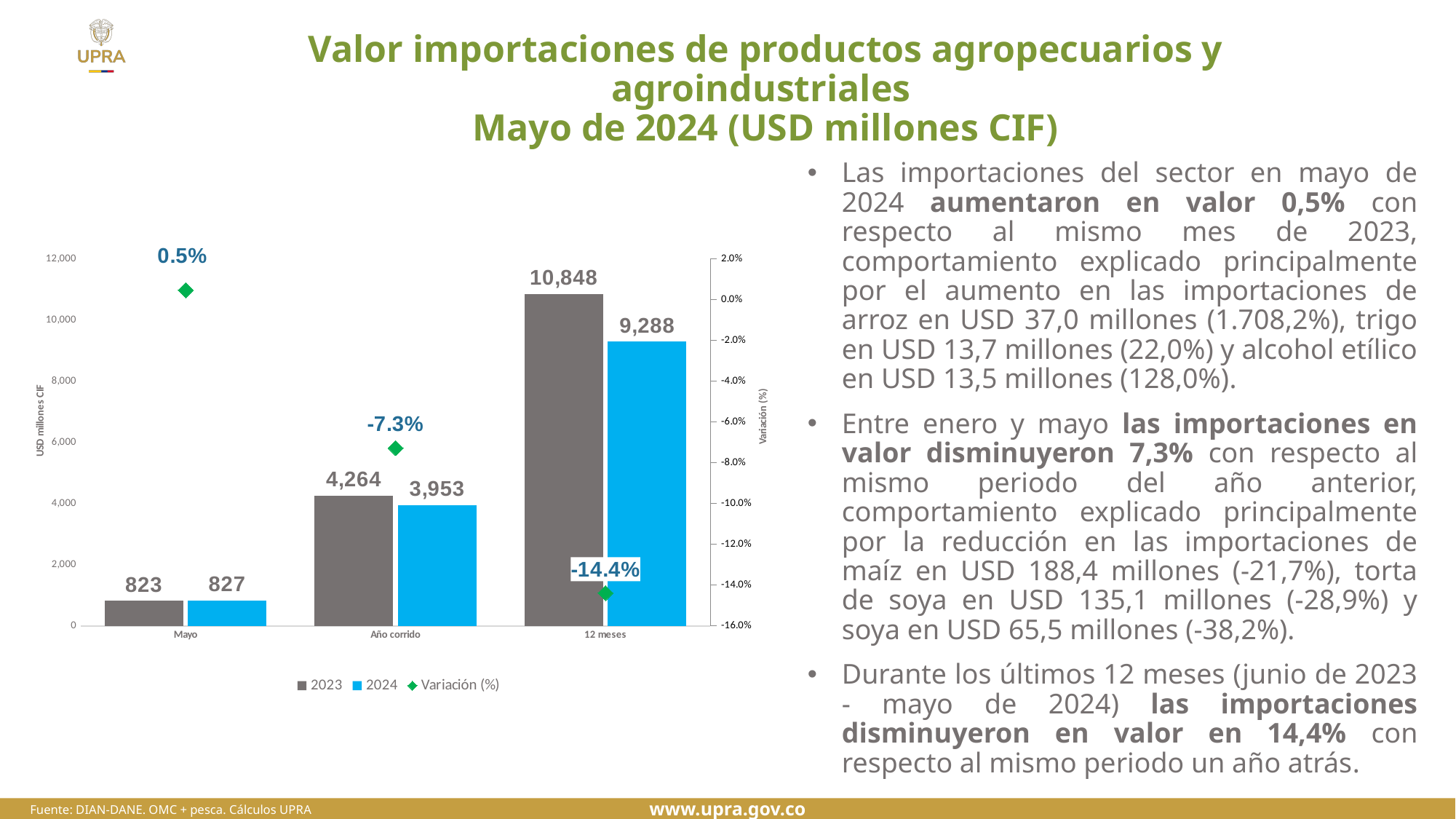
What is the value for 2024 in the Año corrido category? 3,953 How many categories are shown on the x axis? 3 Which category has the lowest 2024 value? Mayo Is the 2024 value for 12 meses greater or less than 8,000? greater What kind of chart is used to show the 2023 and 2024 values? bar chart What is the Variación (%) value for the 12 meses category? -14.4% Which is larger in the Año corrido category, the 2023 value or the 2024 value? 2023 What is the value for 2023 in the Mayo category? 823 What is the difference between the 2023 and 2024 values in the 12 meses category? 1,560 What is the label of the right-hand vertical axis? Variación (%) Which category has the highest 2023 value? 12 meses How many series does the legend list? 3